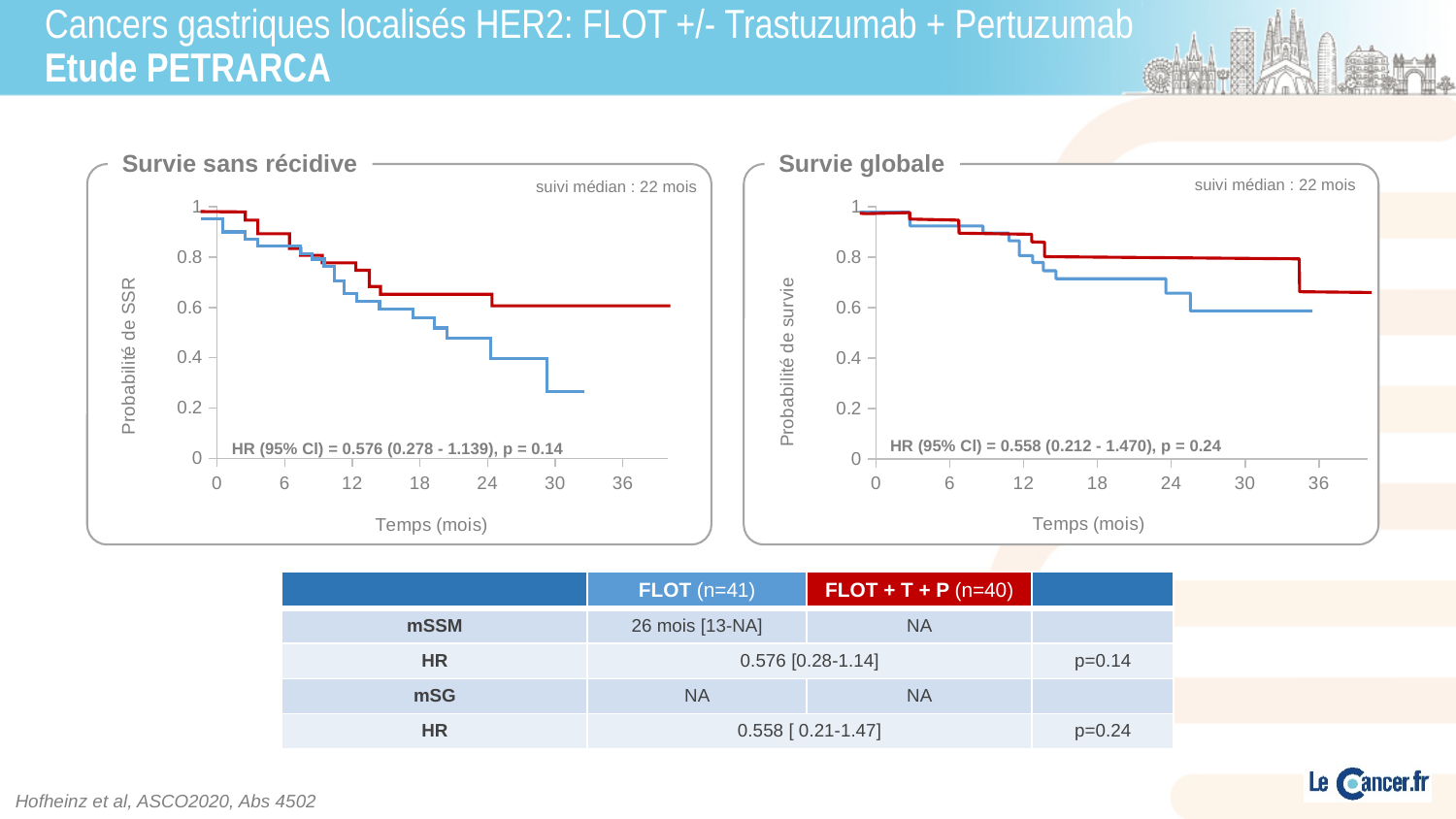
In the 'Survie sans récidive' chart, which curve is higher at 24 months, the red or the blue? red In the 'Survie sans récidive' chart, is the value of the red curve at 30 months greater or less than 0.4? greater In the 'Survie sans récidive' chart, what is the hazard ratio printed on the chart? 0.576 In the 'Survie globale' chart, what is the p-value printed on the chart? p = 0.24 What is the median follow-up stated on the 'Survie sans récidive' chart? 22 mois In the 'Survie globale' chart, do the curves rise or fall as time increases along the x axis? fall What kind of chart is the 'Survie globale' chart? line chart In the 'Survie globale' chart, what is the 95% confidence interval of the hazard ratio printed on the chart? 0.212 - 1.470 In the 'Survie globale' chart, is the value of the red curve at 30 months greater or less than 0.6? greater In the 'Survie sans récidive' chart, is the value of the blue curve at 30 months greater or less than 0.4? less What kind of chart is the 'Survie sans récidive' chart? line chart